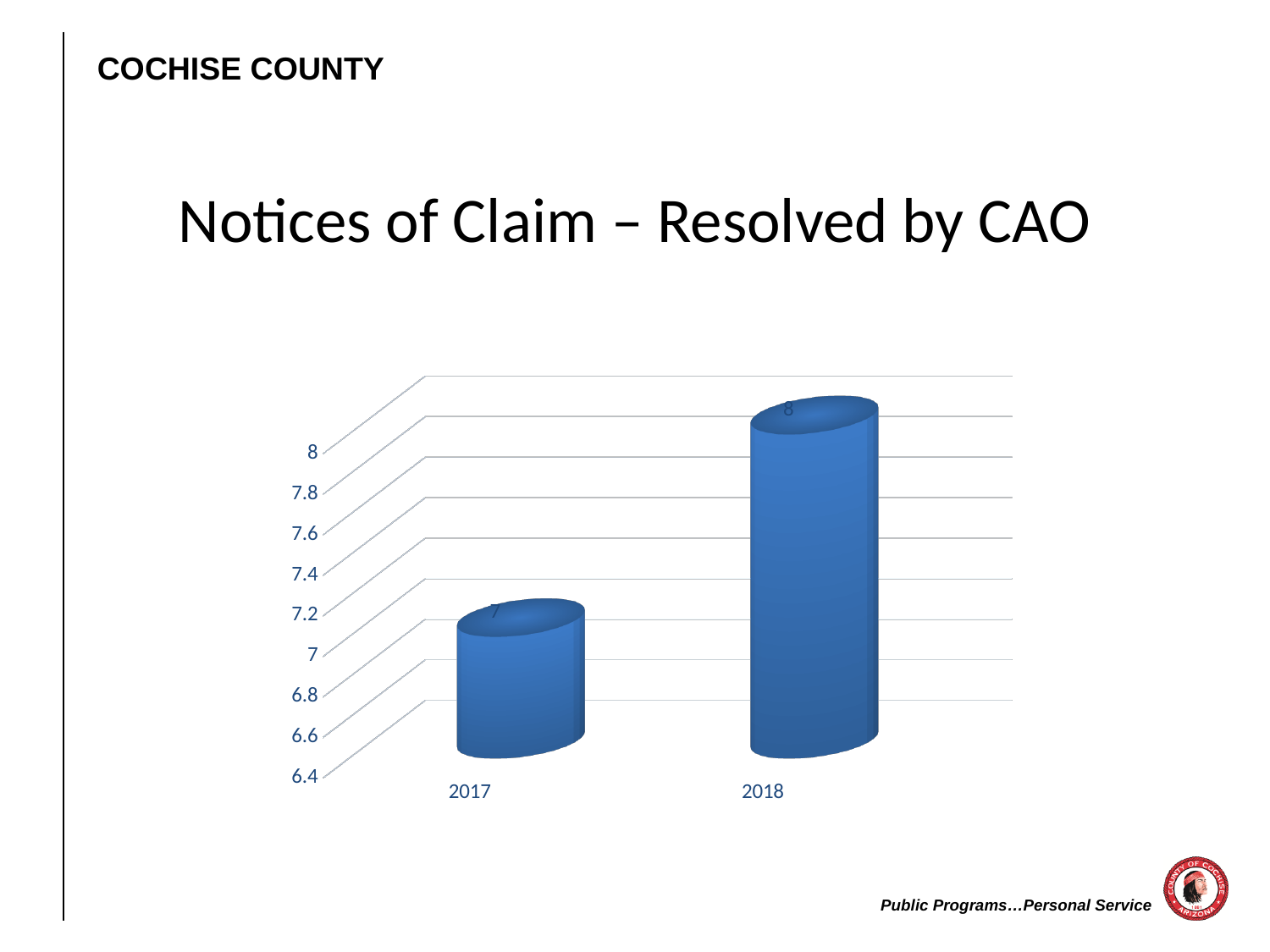
Do the values rise or fall from 2017 to 2018? rise What is the value for 2017? 7 Which is larger, the value for 2017 or the value for 2018? 2018 Is the value for 2018 greater or less than 7.4? greater What is the title of the chart? Notices of Claim – Resolved by CAO Which year has the lowest value? 2017 Is the value for 2017 greater or less than 7.6? less What kind of chart is shown on the slide? bar chart Which year has the highest value? 2018 How many years are shown on the chart? 2 What is the difference between the values for 2018 and 2017? 1 What is the value for 2018? 8